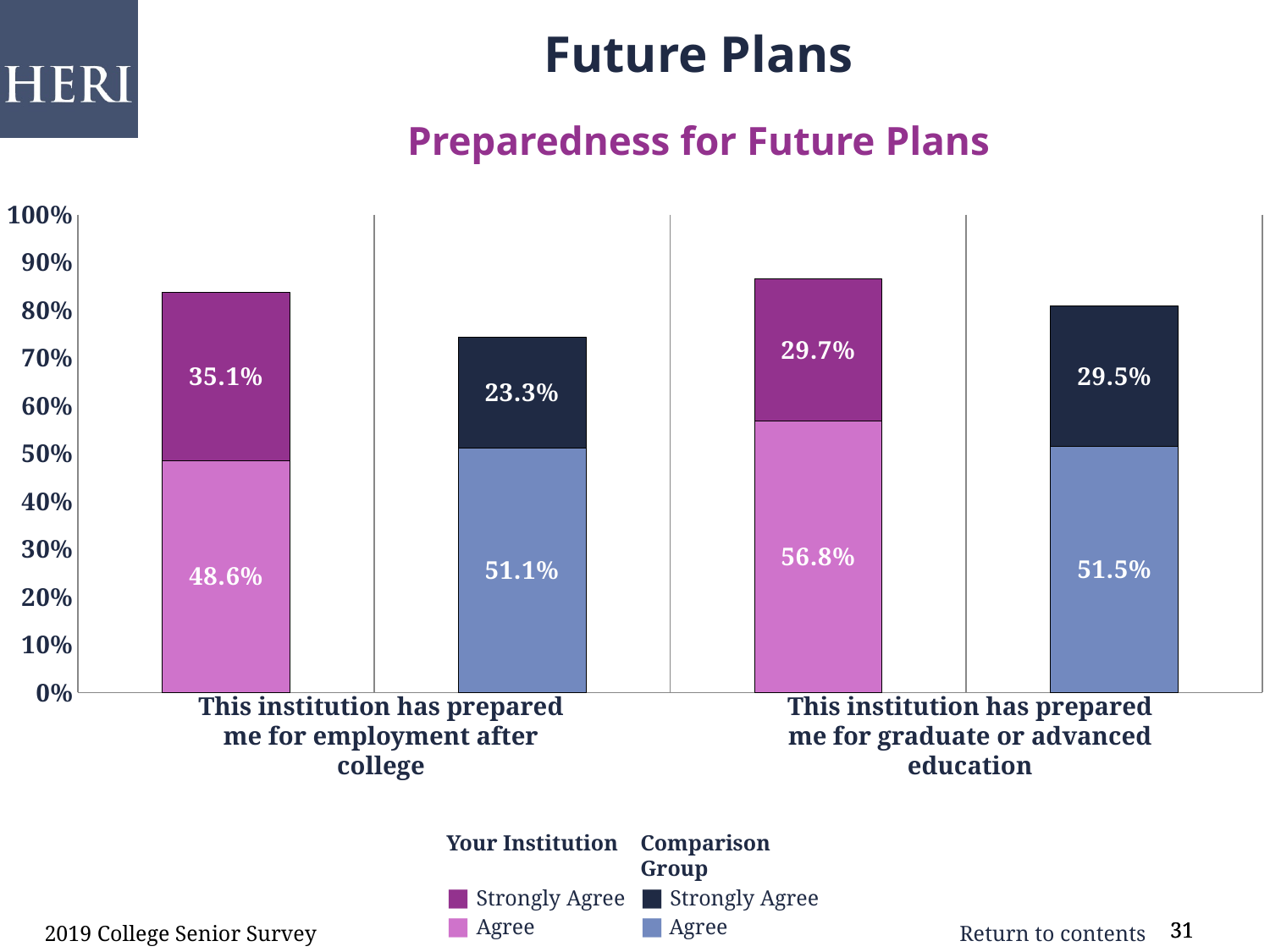
How many survey statements (categories) are shown on the x axis? 2 What is the total percentage (Agree plus Strongly Agree) for Your Institution on 'This institution has prepared me for employment after college'? 83.7% What percentage of Your Institution respondents agree that the institution has prepared them for graduate or advanced education? 56.8% What kind of chart is shown on the slide? Stacked bar chart How many series does the legend list? 4 What percentage of Comparison Group respondents agree that the institution has prepared them for graduate or advanced education? 51.5% What percentage of Your Institution respondents strongly agree that the institution has prepared them for employment after college? 35.1% For preparation for graduate or advanced education, which group has the larger Agree percentage, Your Institution or the Comparison Group? Your Institution What is the total percentage (Agree plus Strongly Agree) for the Comparison Group on 'This institution has prepared me for employment after college'? 74.4% What is the title of the chart? Preparedness for Future Plans Is the total stacked bar for the Comparison Group on preparation for employment after college greater or less than 80%? less What is the difference between the Strongly Agree percentages for Your Institution and the Comparison Group on preparation for employment after college? 11.8%